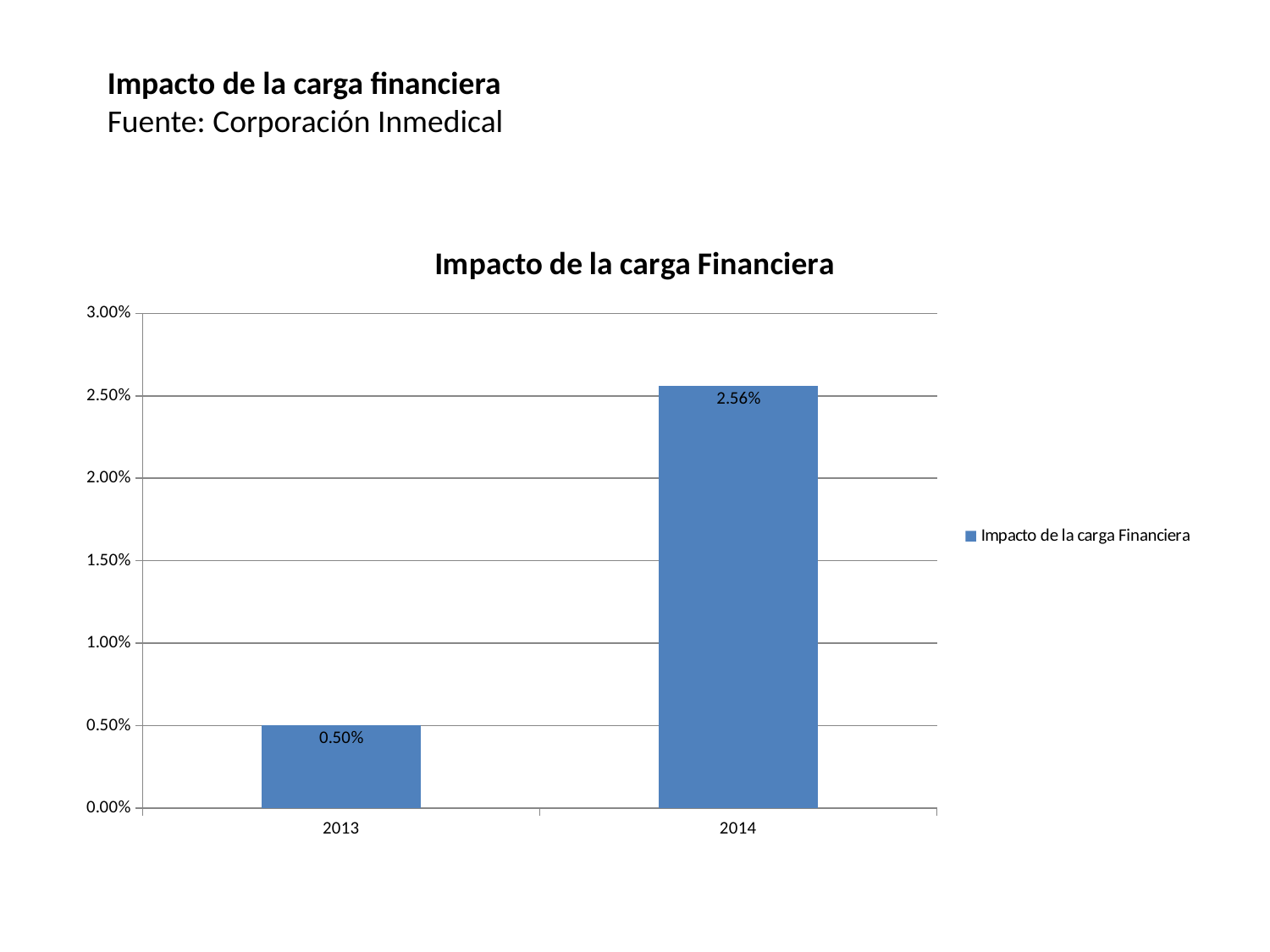
How many series does the legend list? 1 Is the value for 2013 greater or less than 1.00%? less What is the value for 2014? 2.56% Which year has the highest value? 2014 Which is larger, the value for 2013 or the value for 2014? 2014 How many categories are shown on the x axis? 2 Which year has the lowest value? 2013 What kind of chart is shown? bar chart What is the difference between the values for 2014 and 2013? 2.06% What is the value for 2013? 0.50% Is the value for 2014 greater or less than 2.00%? greater What is the title of the chart? Impacto de la carga Financiera